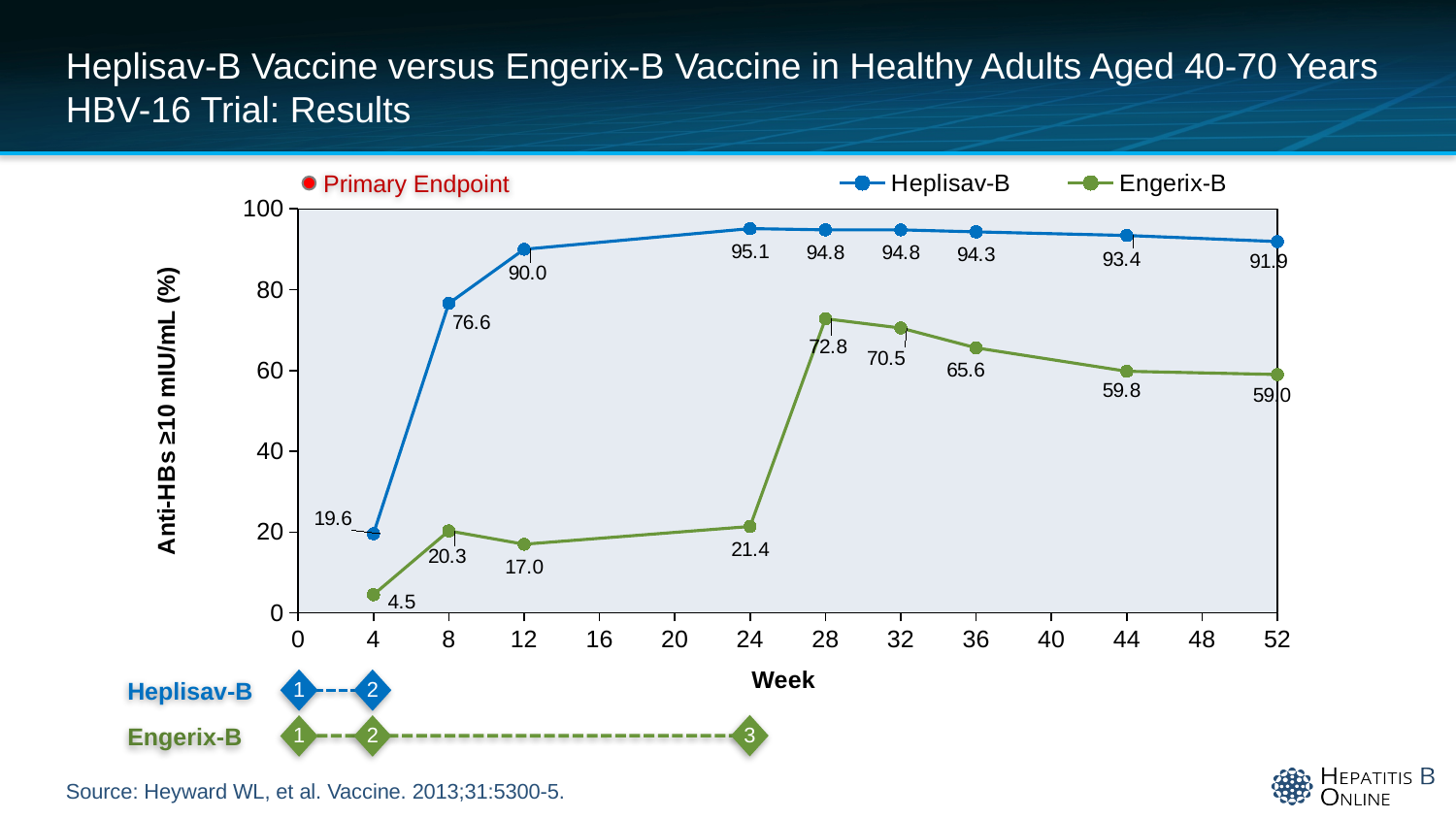
How many data points are plotted for the Heplisav-B series? 9 What is the Heplisav-B value at week 12? 90.0 What is the label of the y axis? Anti-HBs ≥10 mIU/mL (%) What kind of chart is shown on the slide? Line chart What is the Engerix-B value at week 4? 4.5 What is the Engerix-B value at week 28? 72.8 How many series does the chart legend list for the plotted lines? 2 Is the Engerix-B value at week 24 greater or less than 40? less What is the difference between the Heplisav-B and Engerix-B values at week 52? 32.9 Which series has the higher value at week 8, Heplisav-B or Engerix-B? Heplisav-B At which week does Heplisav-B reach its highest value? Week 24 At which week is the Engerix-B value lowest? Week 4